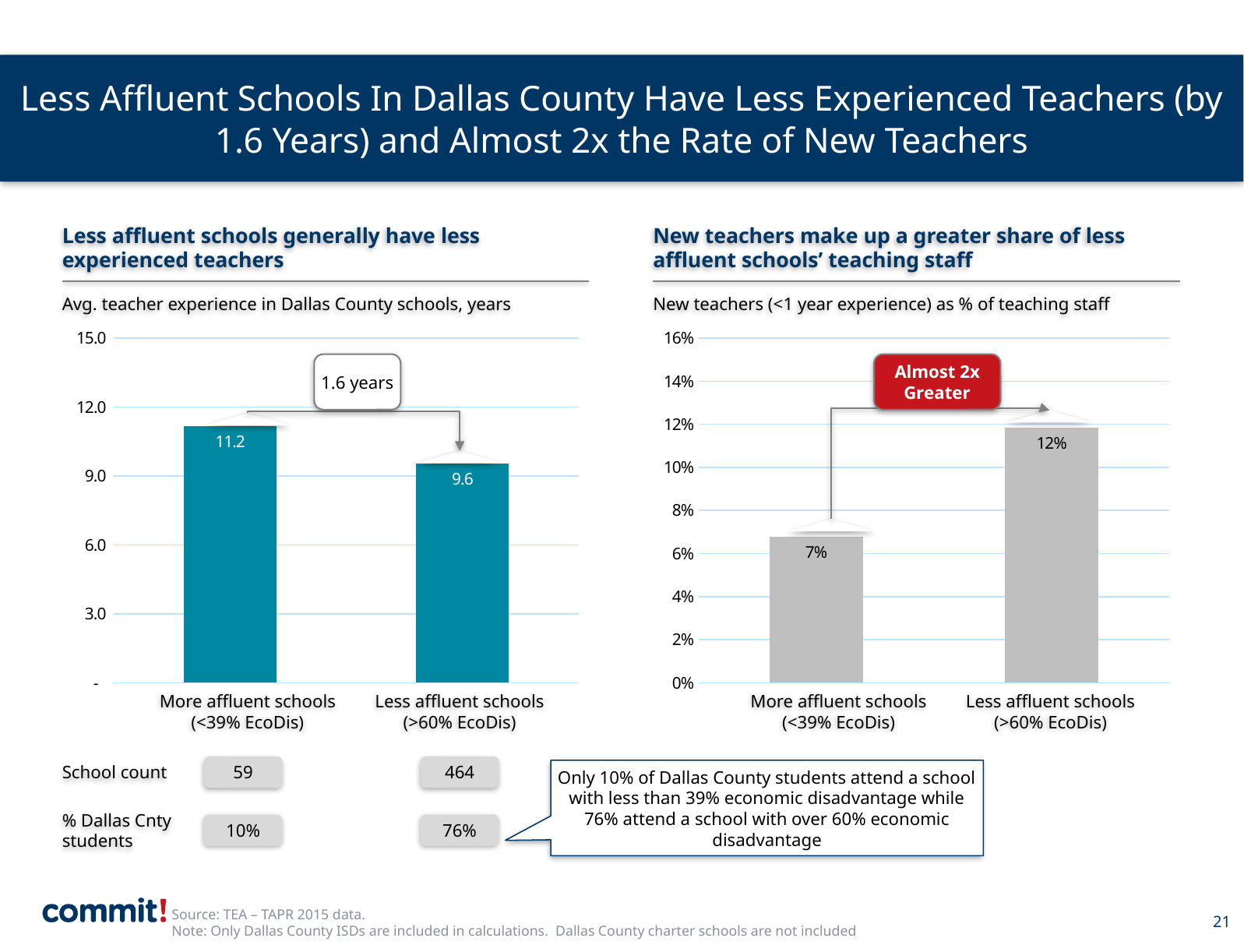
In the left chart (Avg. teacher experience), is the value for Less affluent schools greater or less than 12.0? less In the left chart (Avg. teacher experience in Dallas County schools, years), what is the value for More affluent schools (<39% EcoDis)? 11.2 In the right chart (New teachers as % of teaching staff), what is the value for More affluent schools (<39% EcoDis)? 7% What text appears in the red callout box on the right chart? Almost 2x Greater In the right chart (New teachers as % of teaching staff), which is larger: the value for More affluent schools or Less affluent schools? Less affluent schools In the left chart (Avg. teacher experience), which category has the highest value? More affluent schools (<39% EcoDis) In the left chart (Avg. teacher experience), what is the difference between the More affluent schools and Less affluent schools values? 1.6 In the right chart (New teachers as % of teaching staff), how many categories are plotted? 2 In the right chart (New teachers as % of teaching staff), what is the value for Less affluent schools (>60% EcoDis)? 12% In the right chart (New teachers as % of teaching staff), which category has the lowest value? More affluent schools (<39% EcoDis) In the left chart (Avg. teacher experience in Dallas County schools, years), what is the value for Less affluent schools (>60% EcoDis)? 9.6 What type of chart is the left chart (Avg. teacher experience)? bar chart